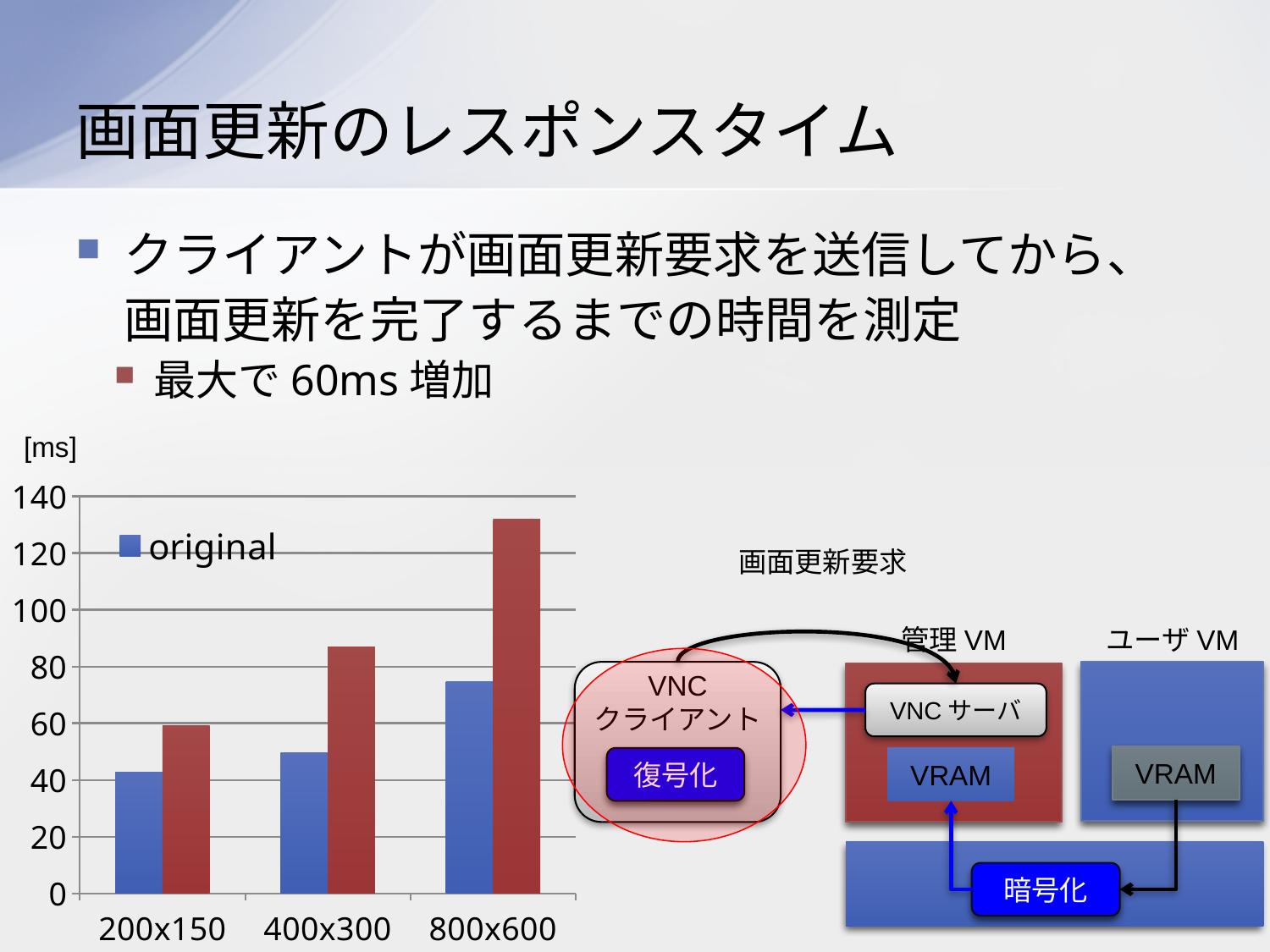
How many series does the chart's legend list? 1 Which is larger at 800x600: the original bar or the red bar next to it? the red bar Which category has the highest value for the original series? 800x600 What kind of chart is shown on the slide? bar chart Is the value for original at 800x600 greater or less than 60? greater How many categories are shown on the x axis of the chart? 3 Which category has the lowest value for the original series? 200x150 Is the value for original at 200x150 greater or less than 60? less What series name appears in the chart's legend? original Do the values of the original series rise or fall from 200x150 to 800x600? rise What unit is shown above the y axis of the chart? [ms] Is the value for original at 400x300 greater or less than 80? less